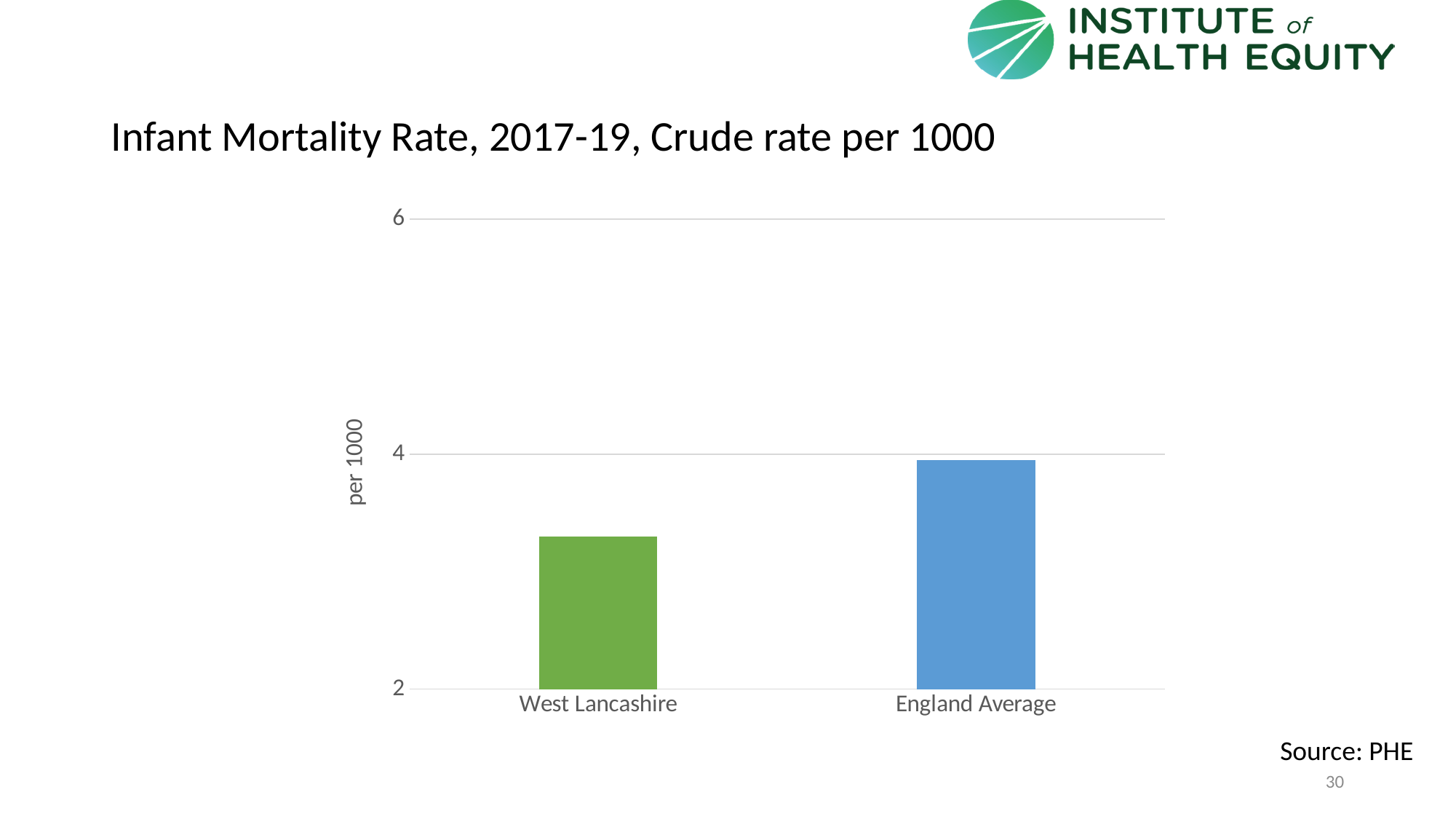
Which category has the lowest infant mortality rate? West Lancashire Is the value for England Average greater or less than 6? less Is the value for England Average greater or less than 2? greater Is the value for West Lancashire greater or less than 4? less What is the source cited for the chart data? PHE What is the title of the chart? Infant Mortality Rate, 2017-19, Crude rate per 1000 Which category has the highest infant mortality rate? England Average How many categories are plotted in the chart? 2 Is the infant mortality rate for West Lancashire higher or lower than the England Average? lower What is the label on the vertical axis? per 1000 What kind of chart is shown on the slide? bar chart